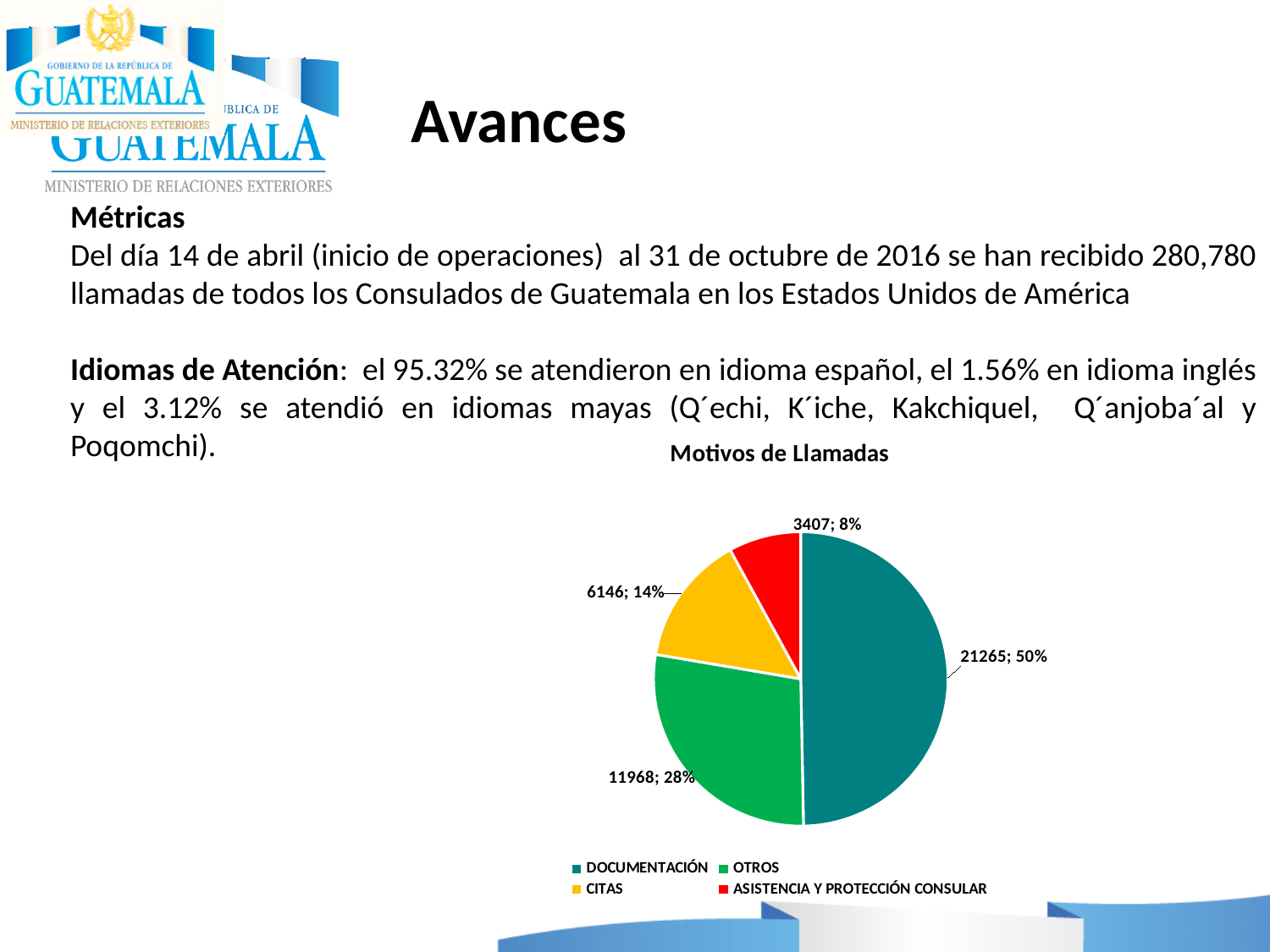
What value is shown for ASISTENCIA Y PROTECCIÓN CONSULAR in the pie chart? 3407 What value is shown for OTROS in the pie chart? 11968 What is the difference between the values for DOCUMENTACIÓN and OTROS in the pie chart? 9297 What is the title of the chart on the slide? Motivos de Llamadas What share of the pie does CITAS represent? 14% Which category has the smallest slice in the pie chart? ASISTENCIA Y PROTECCIÓN CONSULAR What share of the pie does DOCUMENTACIÓN represent? 50% How many slices does the "Motivos de Llamadas" pie chart have? 4 Which category has the largest slice in the pie chart? DOCUMENTACIÓN What type of chart is shown under the title "Motivos de Llamadas"? Pie chart What value is shown for CITAS in the pie chart? 6146 What value is shown for DOCUMENTACIÓN in the pie chart? 21265